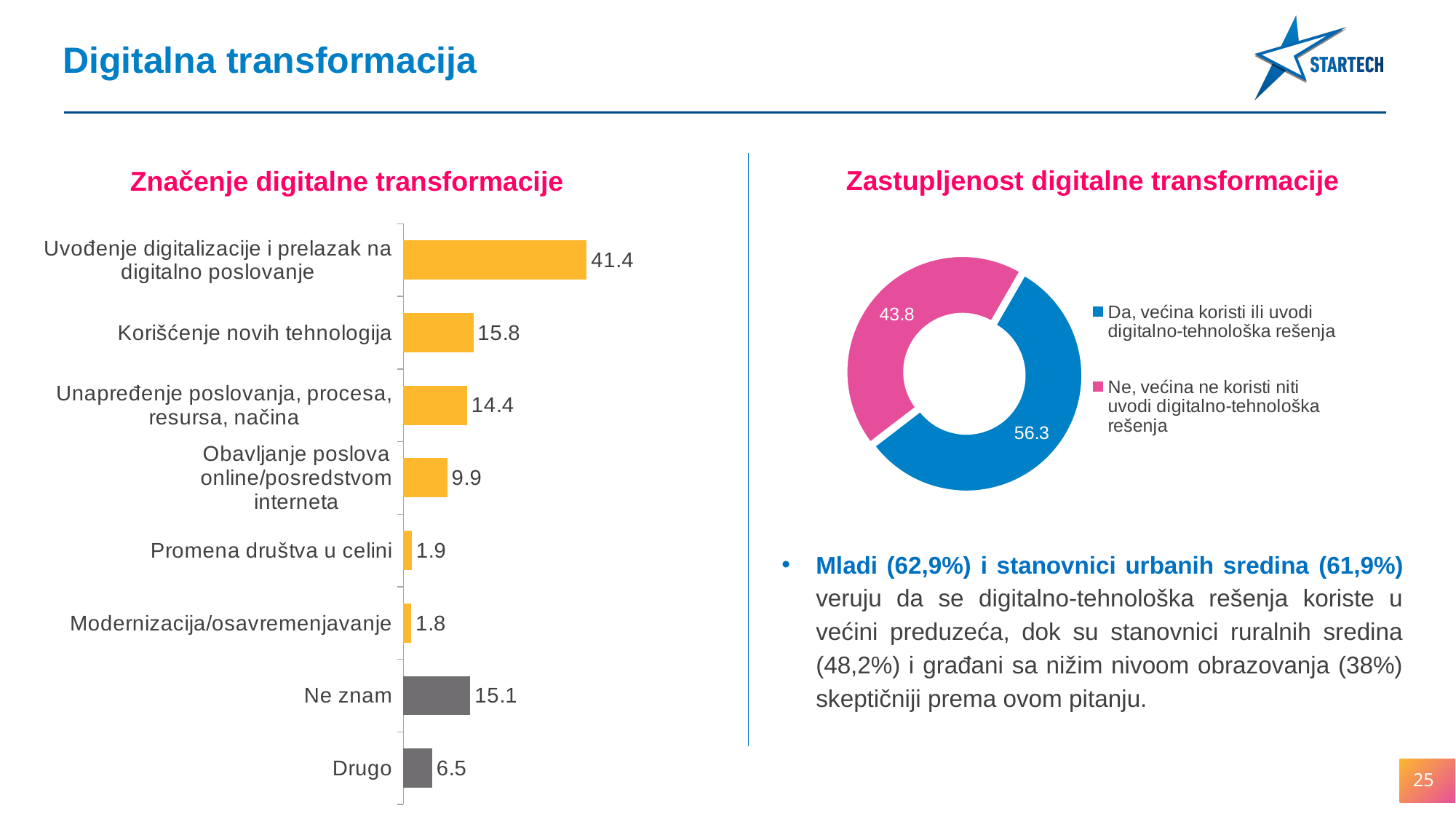
In the 'Zastupljenost digitalne transformacije' chart, what is the value for 'Ne, većina ne koristi niti uvodi digitalno-tehnološka rešenja'? 43.8 In the 'Značenje digitalne transformacije' chart, which is larger: 'Obavljanje poslova online/posredstvom interneta' or 'Drugo'? Obavljanje poslova online/posredstvom interneta How many entries does the legend of the 'Zastupljenost digitalne transformacije' chart list? 2 What type of chart is 'Značenje digitalne transformacije'? Bar chart In the 'Značenje digitalne transformacije' chart, which category has the lowest value? Modernizacija/osavremenjavanje In the 'Značenje digitalne transformacije' chart, which category has the highest value? Uvođenje digitalizacije i prelazak na digitalno poslovanje In the 'Značenje digitalne transformacije' chart, what is the value for 'Korišćenje novih tehnologija'? 15.8 In the 'Zastupljenost digitalne transformacije' chart, what is the value for 'Da, većina koristi ili uvodi digitalno-tehnološka rešenja'? 56.3 In the 'Značenje digitalne transformacije' chart, what is the difference between 'Uvođenje digitalizacije i prelazak na digitalno poslovanje' and 'Korišćenje novih tehnologija'? 25.6 How many categories are shown in the 'Značenje digitalne transformacije' chart? 8 What type of chart is 'Zastupljenost digitalne transformacije'? Doughnut chart In the 'Značenje digitalne transformacije' chart, what is the value for 'Ne znam'? 15.1